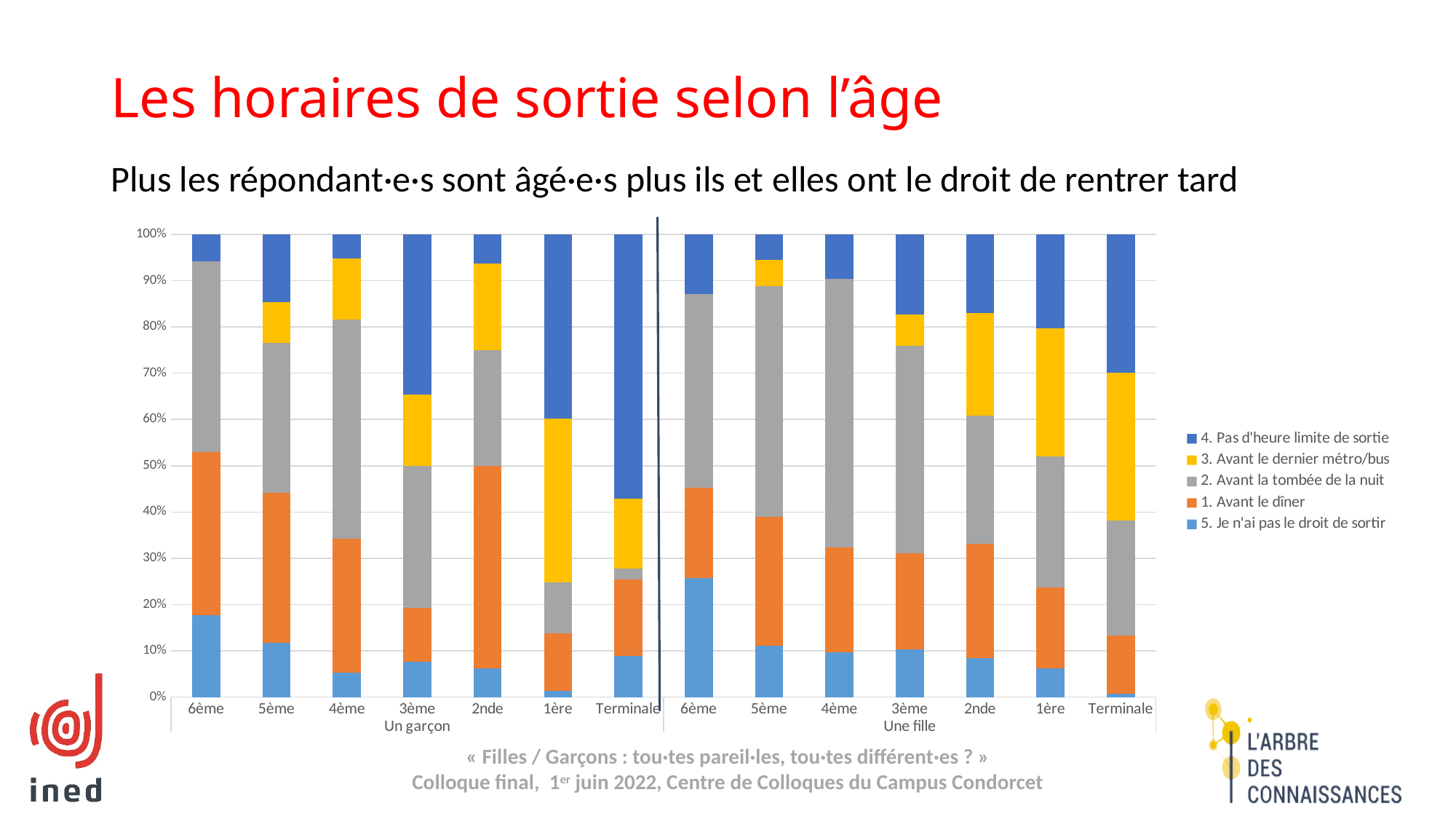
Is the share of '4. Pas d'heure limite de sortie' for Terminale in the 'Une fille' group greater or less than 40%? less Which bar has the largest share for '5. Je n'ai pas le droit de sortir'? 6ème (Une fille) How many series does the chart legend list? 5 What kind of chart is shown on the slide? Stacked bar chart Which is larger: the share of '4. Pas d'heure limite de sortie' for Terminale boys ('Un garçon') or for Terminale girls ('Une fille')? Terminale boys (Un garçon) Is the share of '5. Je n'ai pas le droit de sortir' for 6ème in the 'Un garçon' group greater or less than 20%? less Is the share of '5. Je n'ai pas le droit de sortir' for 6ème in the 'Une fille' group greater or less than 20%? greater How many bars are plotted in the chart in total? 14 How many grade levels are shown within the 'Un garçon' group? 7 Which colour represents '3. Avant le dernier métro/bus' in the chart? Yellow